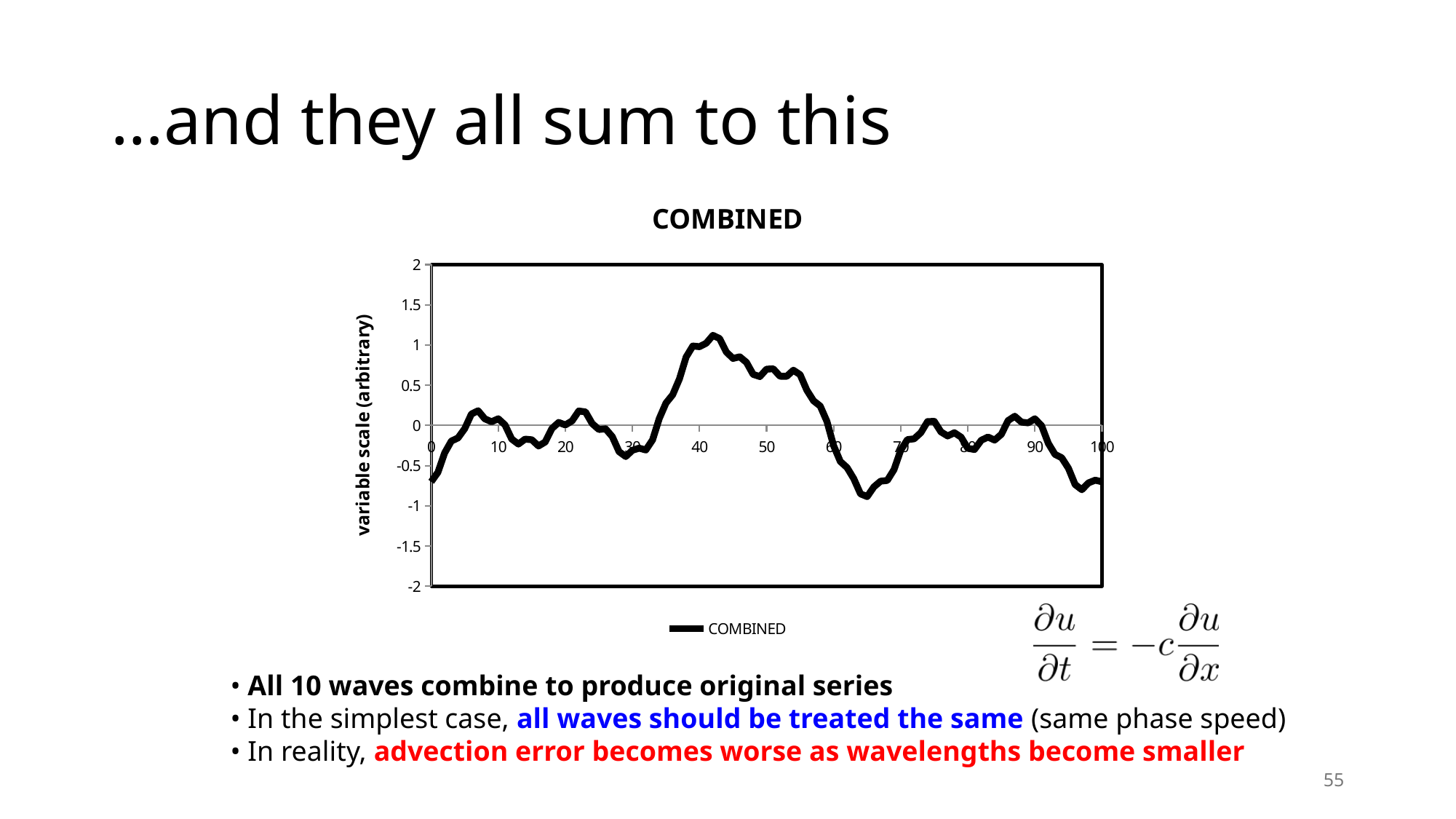
What is the title of the chart? COMBINED Is the value of the COMBINED line at x = 40 greater or less than 0.5? greater Is the value of the COMBINED line at x = 0 greater or less than 0? less Does the COMBINED line rise or fall between x = 55 and x = 65? fall Is the value of the COMBINED line at x = 65 greater or less than -0.5? less How many series does the chart's legend list? 1 What is the label on the vertical axis of the chart? variable scale (arbitrary) Does the COMBINED line rise or fall between x = 30 and x = 40? rise What kind of chart is shown on the slide? line chart